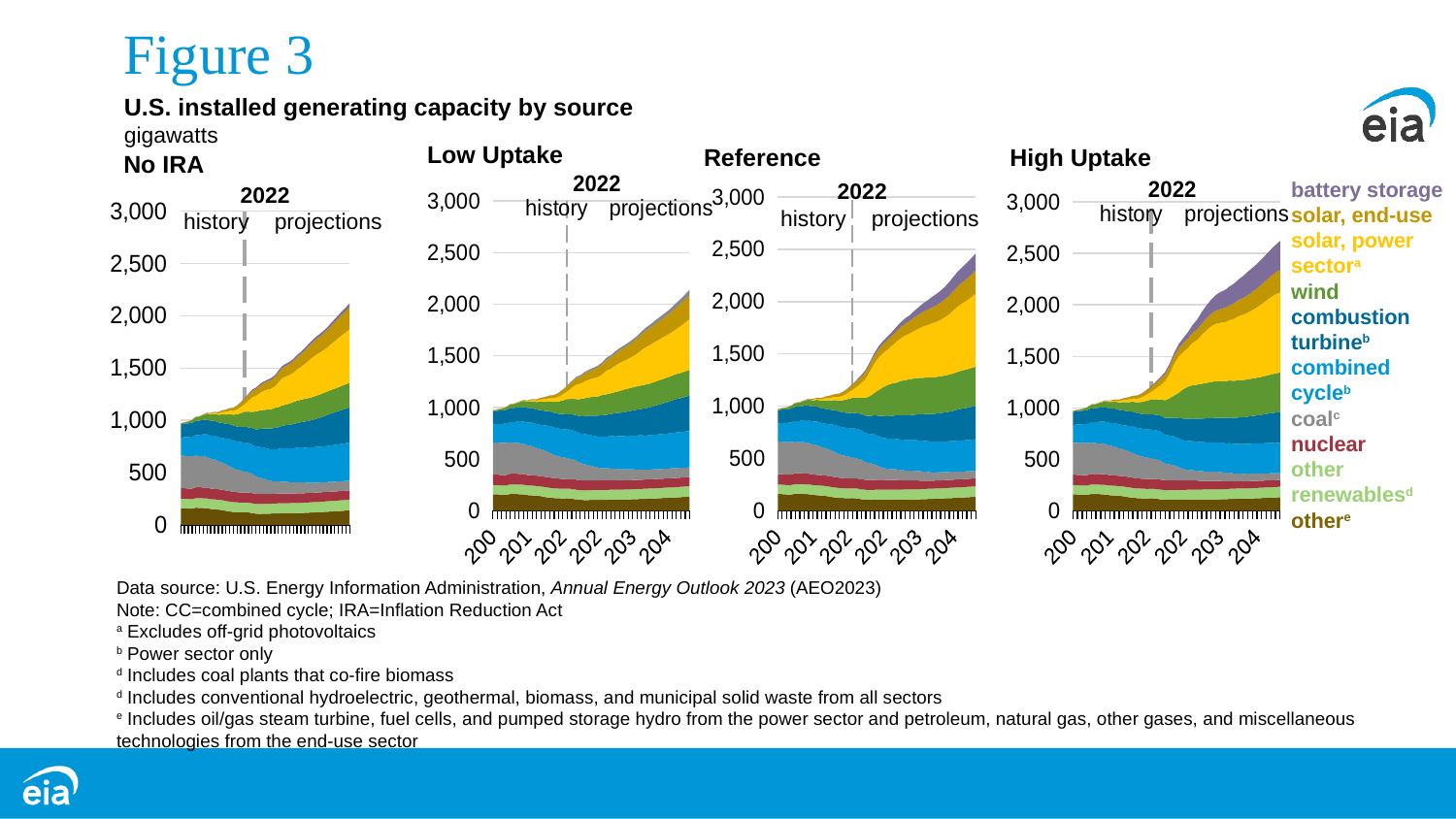
At the end of the projection period, which has the larger total installed capacity: the High Uptake chart or the No IRA chart? High Uptake In the High Uptake chart, is the total installed capacity at the end of the projection period greater or less than 2,000 gigawatts? greater What is the title of the figure shown on the slide? U.S. installed generating capacity by source In the No IRA chart, is the total installed capacity at the end of the projection period greater or less than 1,500 gigawatts? greater How many sources does the legend list? 10 How many charts (scenario panels) are shown on the slide? 4 In the Low Uptake chart, is the total installed capacity at the 2022 dashed line greater or less than 1,000 gigawatts? greater In what unit is installed generating capacity measured on the charts? gigawatts What kind of chart is used in each of the four panels on the slide? stacked area chart In the Reference chart, does total installed capacity rise or fall over the projection period after 2022? rise Which scenario chart shows the highest total installed capacity at the end of the projection period? High Uptake